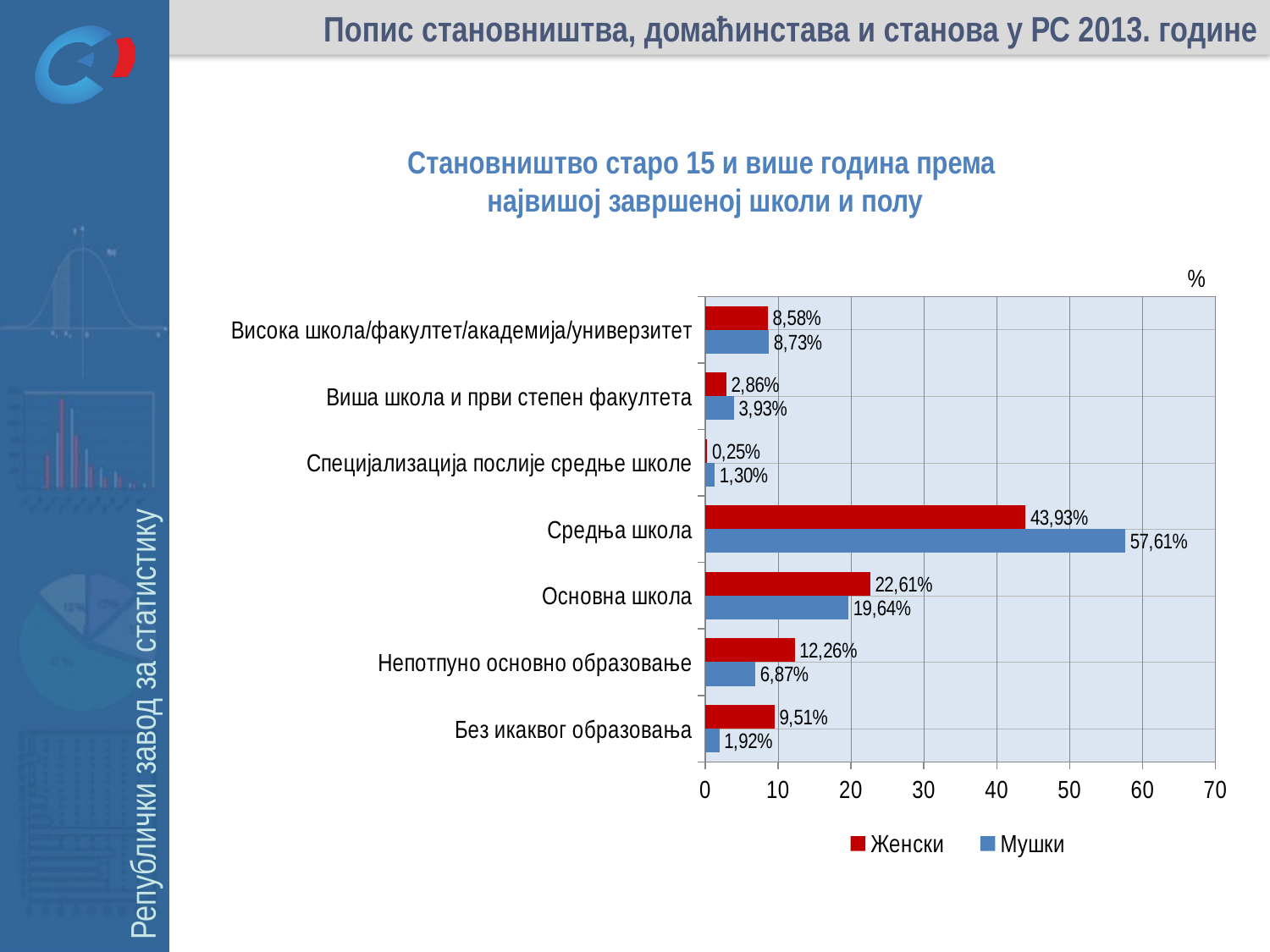
What kind of chart is shown on the slide? Bar chart Which is larger in the Основна школа category, the Женски value or the Мушки value? Женски How many education categories are shown on the chart? 7 What is the difference between the Мушки and Женски values for Средња школа? 13,68% Which category has the highest value for Мушки? Средња школа What is the value for Мушки in the Средња школа category? 57,61% What is the value for Женски in the Средња школа category? 43,93% Which series is shown in red? Женски What is the value for Мушки in the Без икаквог образовања category? 1,92% How many series does the legend list? 2 Which category has the lowest value for Женски? Специјализација послије средње школе What is the value for Женски in the Непотпуно основно образовање category? 12,26%